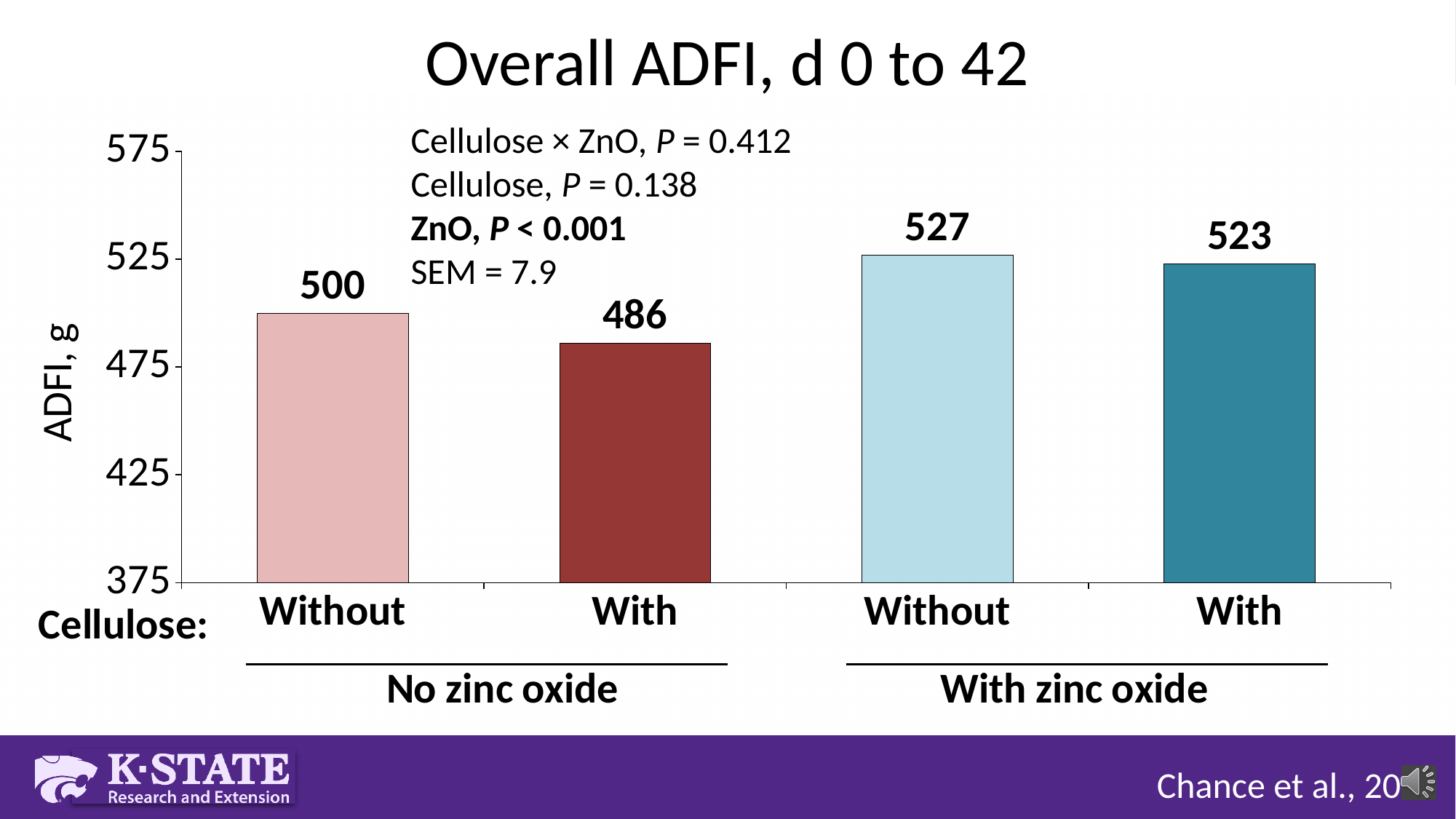
What is the difference in ADFI between the 'Without' cellulose bars in the With zinc oxide and No zinc oxide groups? 27 What is the ADFI value for the 'With' cellulose bar in the No zinc oxide group? 486 What is the ADFI value for the 'Without' cellulose bar in the No zinc oxide group? 500 Which bar has the highest ADFI value? Without cellulose, With zinc oxide (527) How many bars are plotted in the chart? 4 What is the difference in ADFI between the 'Without' and 'With' cellulose bars in the No zinc oxide group? 14 Which bar has the lowest ADFI value? With cellulose, No zinc oxide (486) Which is larger: the ADFI for 'With' cellulose in the No zinc oxide group or 'With' cellulose in the With zinc oxide group? With cellulose, With zinc oxide (523) What is the ADFI value for the 'With' cellulose bar in the With zinc oxide group? 523 What type of chart is shown on the slide? Bar chart What is the ADFI value for the 'Without' cellulose bar in the With zinc oxide group? 527 What is the title of the chart? Overall ADFI, d 0 to 42